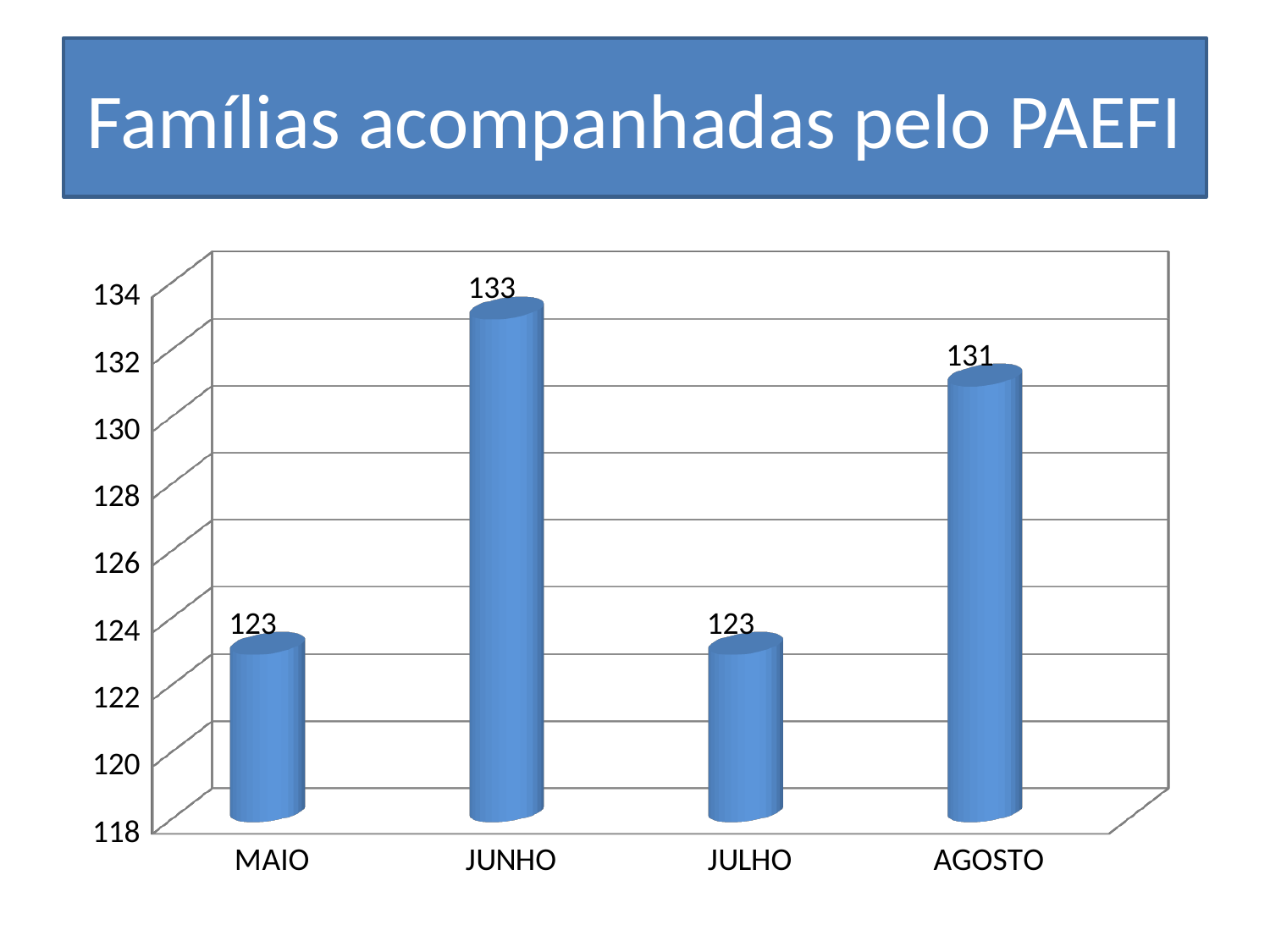
What is the difference between the values for AGOSTO and JULHO? 8 How many months are shown on the x axis? 4 What is the difference between the values for JUNHO and MAIO? 10 Which is larger, the value for JUNHO or the value for AGOSTO? JUNHO What is the value for JUNHO? 133 What is the title of the slide? Famílias acompanhadas pelo PAEFI What is the value for MAIO? 123 What is the value for AGOSTO? 131 What kind of chart is shown on the slide? bar chart Is the value for JULHO greater or less than 124? less Is the value for AGOSTO greater or less than 130? greater Which month has the highest value? JUNHO